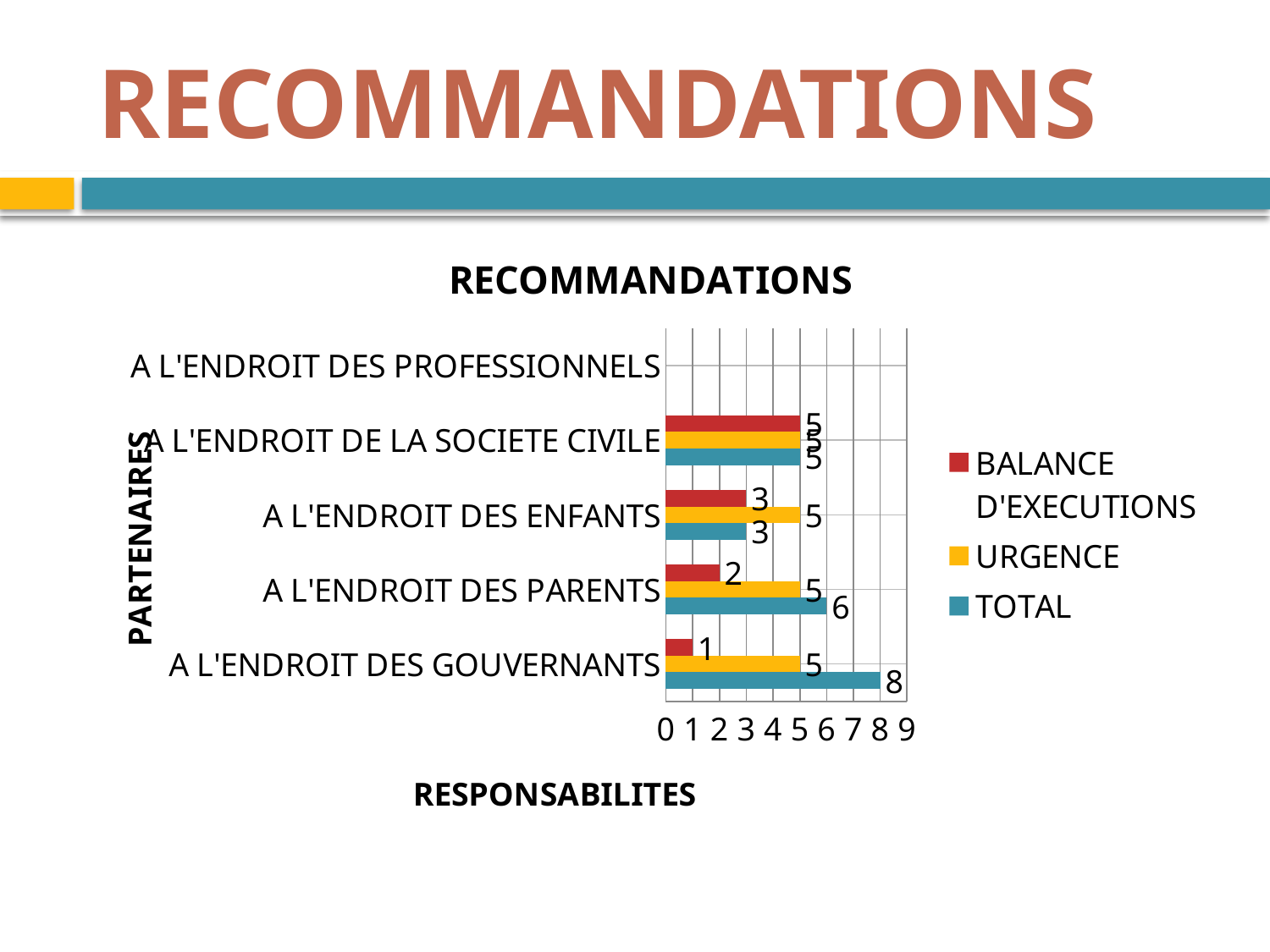
What is the title of the horizontal axis? RESPONSABILITES What is the TOTAL value for A L'ENDROIT DES GOUVERNANTS? 8 What is the URGENCE value for A L'ENDROIT DES ENFANTS? 5 What type of chart is shown on the slide? bar chart How many series does the legend list? 3 How many categories are listed on the vertical axis? 5 Which category has the lowest BALANCE D'EXECUTIONS value? A L'ENDROIT DES GOUVERNANTS Which category has the highest TOTAL value? A L'ENDROIT DES GOUVERNANTS Which is larger: the BALANCE D'EXECUTIONS value for A L'ENDROIT DES ENFANTS or for A L'ENDROIT DES PARENTS? A L'ENDROIT DES ENFANTS What is the BALANCE D'EXECUTIONS value for A L'ENDROIT DES PARENTS? 2 What is the difference between the TOTAL value for A L'ENDROIT DES GOUVERNANTS and the TOTAL value for A L'ENDROIT DES PARENTS? 2 What is the BALANCE D'EXECUTIONS value for A L'ENDROIT DE LA SOCIETE CIVILE? 5